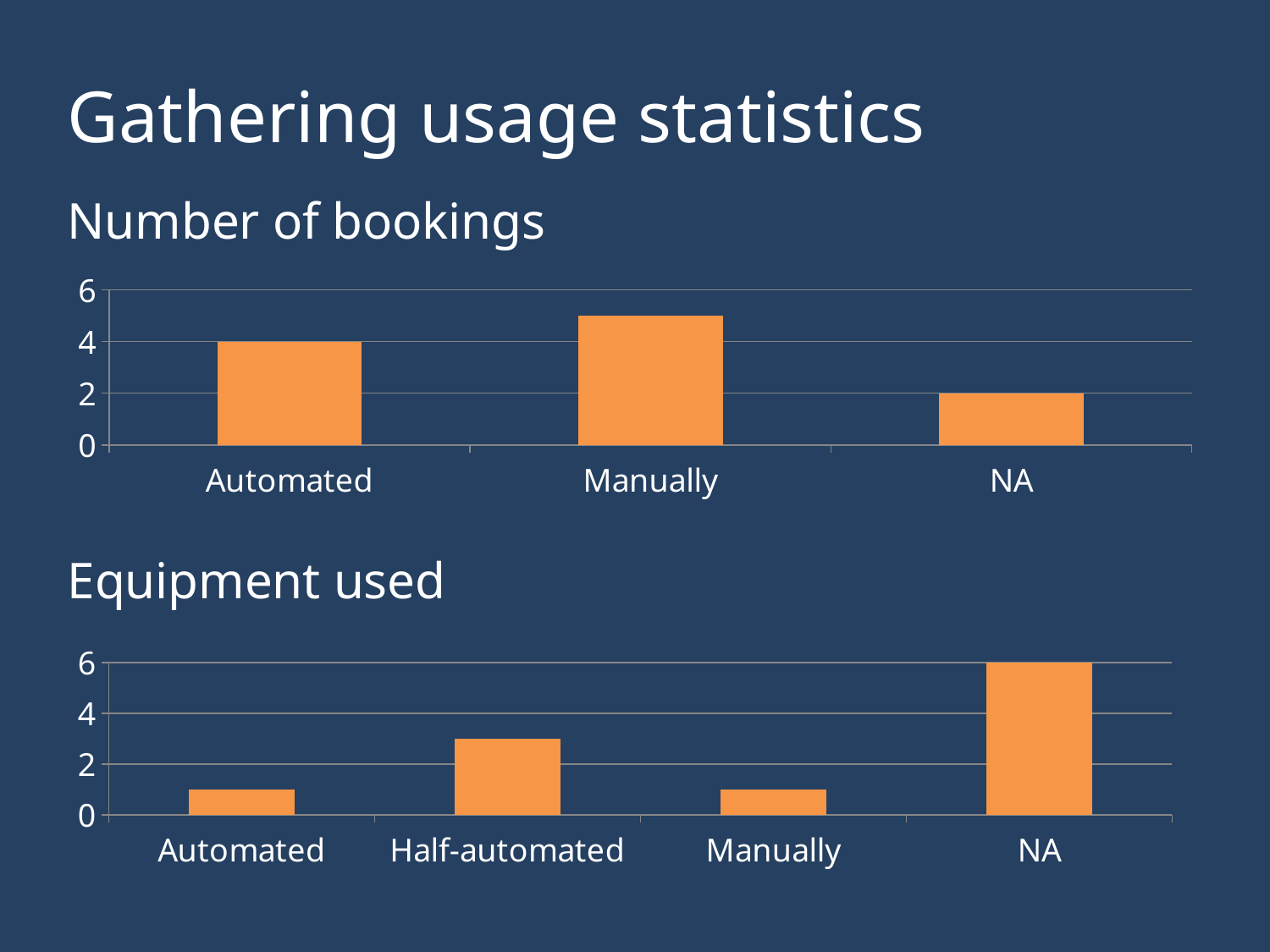
In the Number of bookings chart, how many categories are shown? 3 In the Number of bookings chart, which category has the highest value? Manually In the Equipment used chart, how many categories are shown? 4 In the Number of bookings chart, what is the value for NA? 2 In the Number of bookings chart, what is the difference between the values for Automated and NA? 2 What kind of chart is the Equipment used chart? bar chart In the Number of bookings chart, what is the value for Automated? 4 In the Equipment used chart, what is the value for NA? 6 In the Number of bookings chart, which category has the lowest value? NA In the Equipment used chart, which category has the highest value? NA In the Equipment used chart, is the value for Half-automated greater or less than 2? greater In the Number of bookings chart, is the value for Manually greater or less than 4? greater